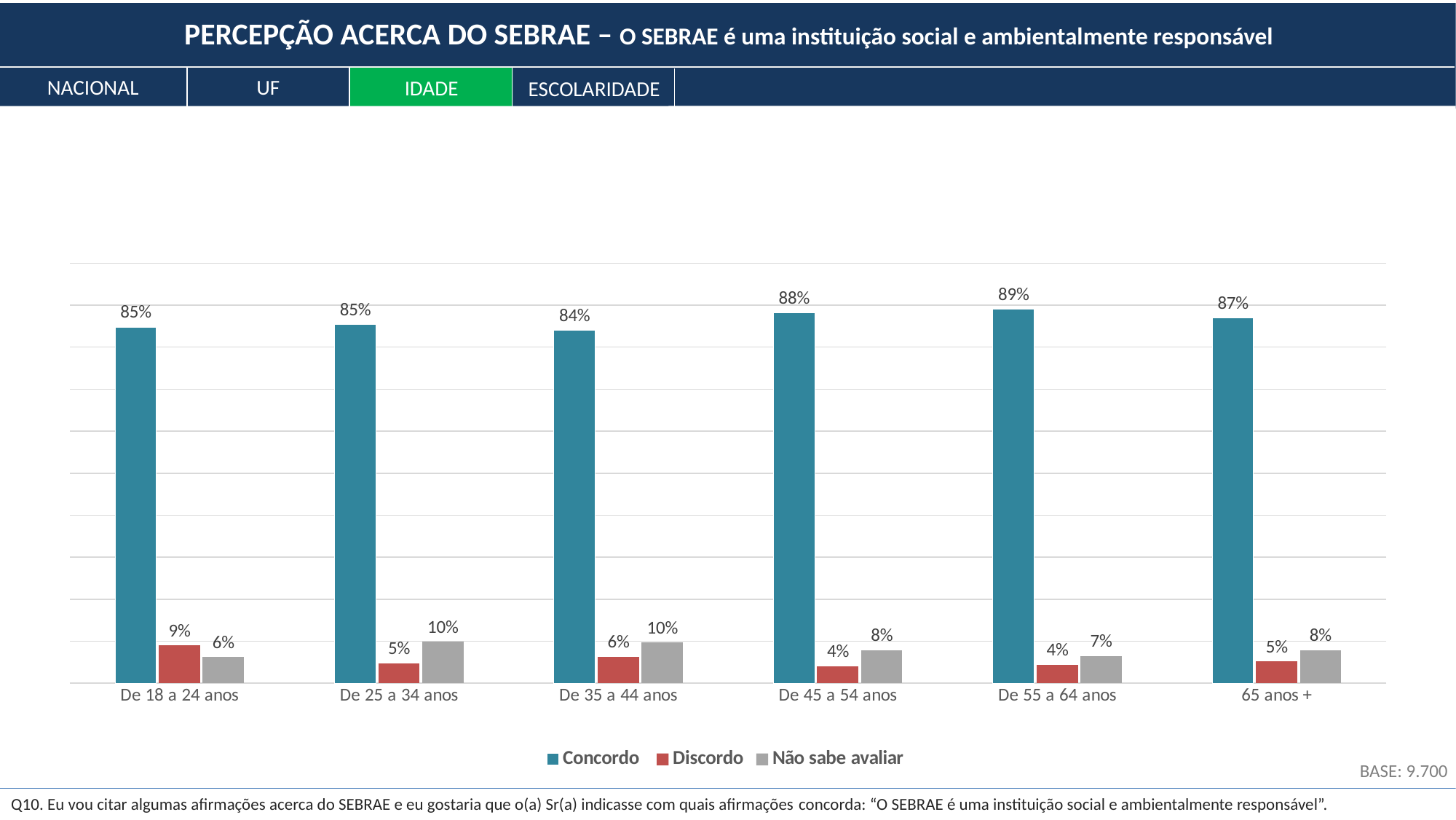
How many series does the legend list? 3 Which age group has the highest Concordo value? De 55 a 64 anos How many age groups are shown on the x axis? 6 What is the Discordo value for De 18 a 24 anos? 9% What kind of chart is shown on the slide? Bar chart Which is larger, the Discordo value for De 18 a 24 anos or for De 45 a 54 anos? De 18 a 24 anos What is the Concordo value for De 45 a 54 anos? 88% What is the Não sabe avaliar value for De 35 a 44 anos? 10% What is the difference between the Concordo values for De 55 a 64 anos and De 18 a 24 anos? 4% Which age group has the highest Discordo value? De 18 a 24 anos Which tab is highlighted in green at the top of the slide? IDADE Which age group has the lowest Concordo value? De 35 a 44 anos